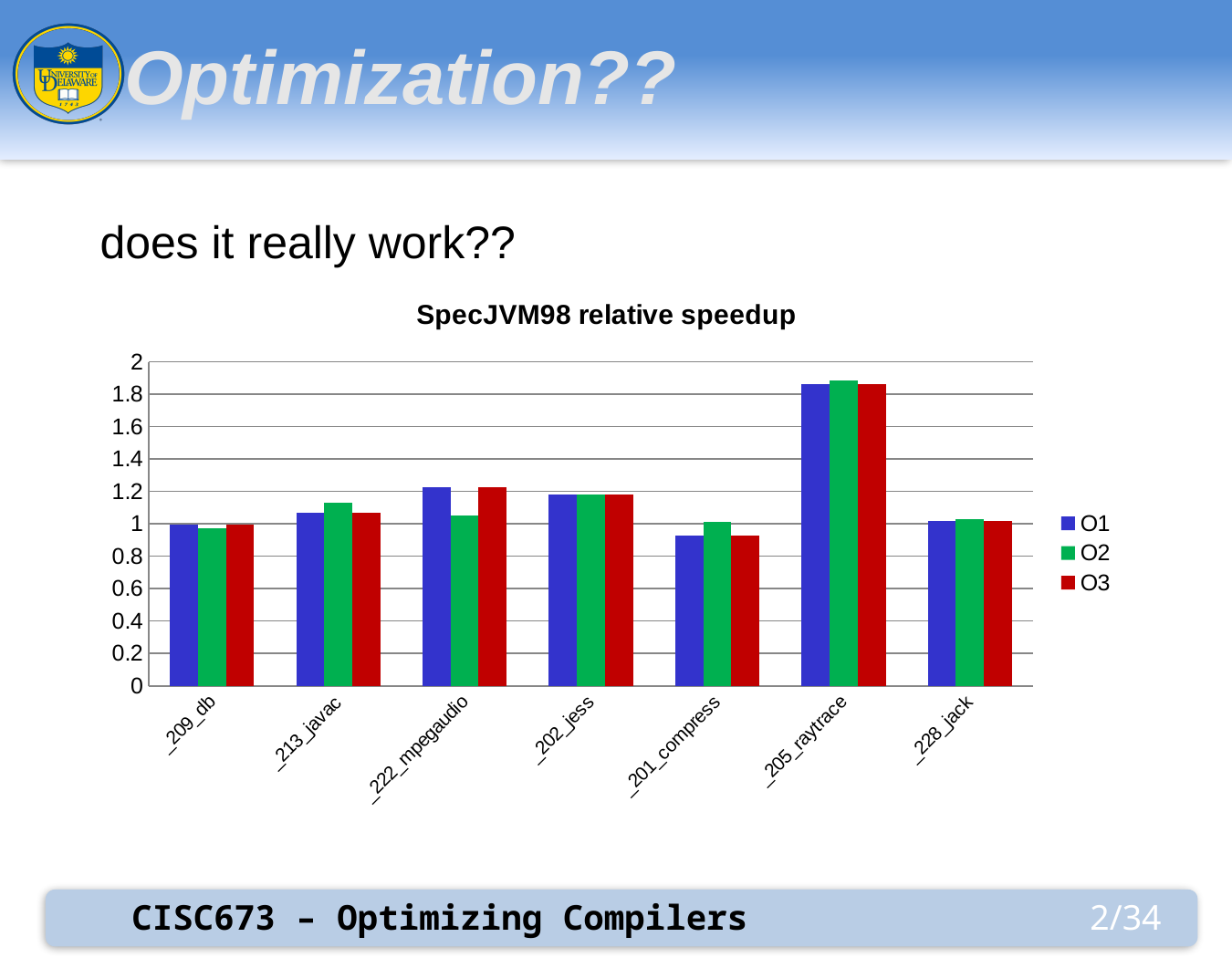
What kind of chart is shown on the slide? bar chart For _201_compress, which series has the larger value, O2 or O3? O2 How many benchmark categories are shown on the x axis? 7 For _222_mpegaudio, which series has the larger value, O1 or O2? O1 Which benchmark has the highest relative speedup for the O1 series? _205_raytrace How many series does the legend list? 3 Which colour represents the O3 series in the legend? red Which benchmark has the lowest relative speedup for the O1 series? _201_compress Is the O1 value for _201_compress greater or less than 1? less Is the O2 value for _213_javac greater or less than 1? greater Is the O1 value for _205_raytrace greater or less than 1.8? greater What is the title of the chart? SpecJVM98 relative speedup